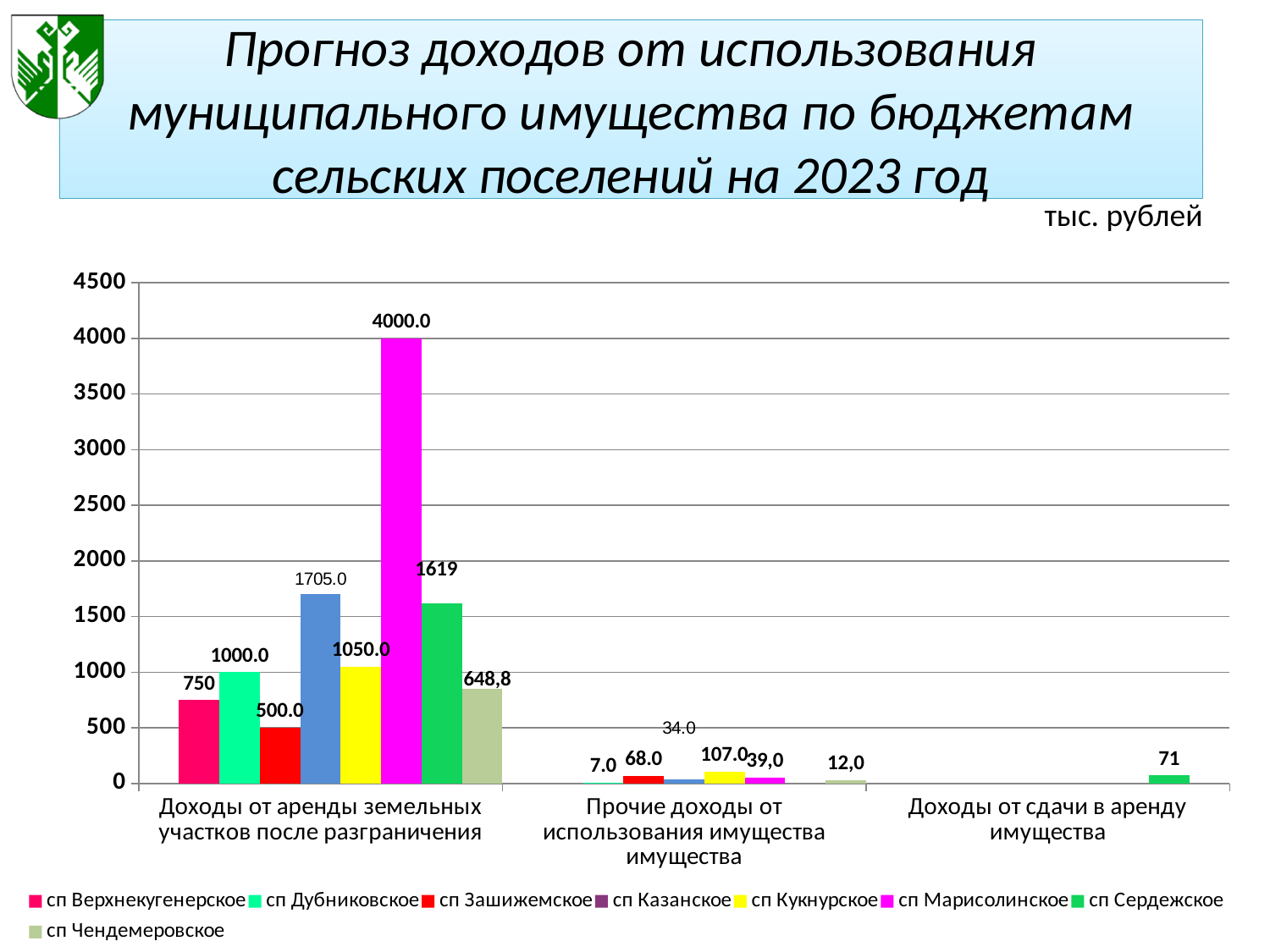
What is the value for сп Кукнурское in the category «Прочие доходы от использования имущества»? 107.0 How many series does the legend list? 8 What is the value for сп Чендемеровское in the category «Доходы от аренды земельных участков после разграничения»? 648,8 In the category «Доходы от аренды земельных участков после разграничения», what is the difference between the values for сп Дубниковское and сп Зашижемское? 500.0 How many categories are shown on the x axis? 3 In what units are the values on the chart given? тыс. рублей What is the value for сп Марисолинское in the category «Доходы от аренды земельных участков после разграничения»? 4000.0 What kind of chart is shown on the slide? Bar chart Which settlement has the highest value in the category «Доходы от аренды земельных участков после разграничения»? сп Марисолинское Which settlement has the lowest value in the category «Доходы от аренды земельных участков после разграничения»? сп Зашижемское What is the value for сп Сердежское in the category «Доходы от сдачи в аренду имущества»? 71